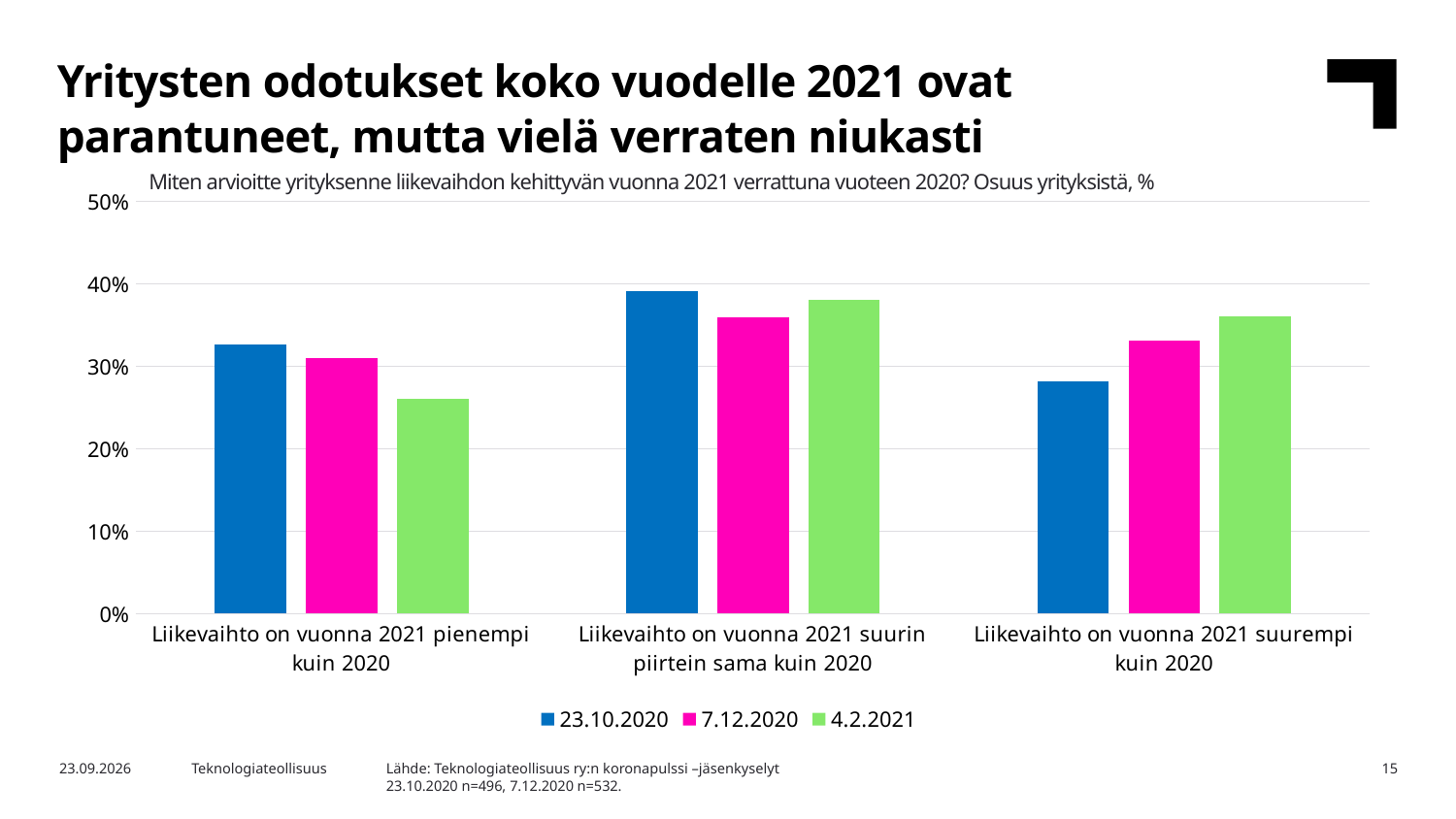
For the 4.2.2021 series, which is larger: the value for 'Liikevaihto on vuonna 2021 pienempi kuin 2020' or for 'Liikevaihto on vuonna 2021 suurempi kuin 2020'? Liikevaihto on vuonna 2021 suurempi kuin 2020 In the category 'Liikevaihto on vuonna 2021 pienempi kuin 2020', which series has the lowest value? 4.2.2021 What kind of chart is shown on the slide? bar chart In the category 'Liikevaihto on vuonna 2021 suurempi kuin 2020', which series has the highest value? 4.2.2021 How many series does the chart's legend list? 3 Is the value for 4.2.2021 in the category 'Liikevaihto on vuonna 2021 pienempi kuin 2020' greater or less than 30%? less For the 23.10.2020 series, which is larger: the value for 'Liikevaihto on vuonna 2021 pienempi kuin 2020' or for 'Liikevaihto on vuonna 2021 suurempi kuin 2020'? Liikevaihto on vuonna 2021 pienempi kuin 2020 Is the value for 7.12.2020 in the category 'Liikevaihto on vuonna 2021 suurempi kuin 2020' greater or less than 30%? greater How many categories are shown on the x axis of the chart? 3 Is the value for 23.10.2020 in the category 'Liikevaihto on vuonna 2021 suurempi kuin 2020' greater or less than 30%? less Which series does the legend list last? 4.2.2021